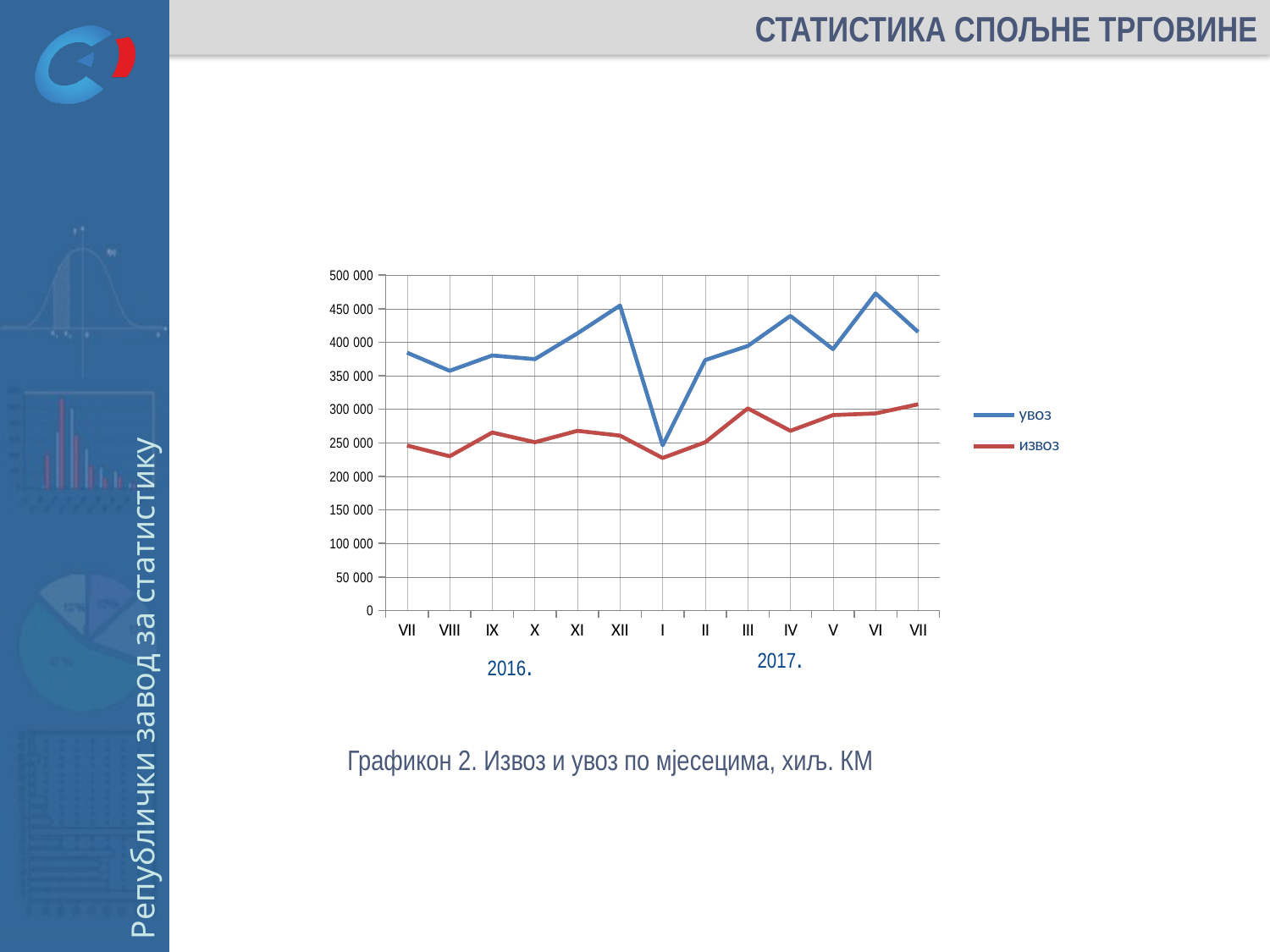
In which month is the увоз (blue) line at its highest? VI 2017 What kind of chart is shown on the slide? line chart In which month is the извоз (red) line at its lowest? I 2017 In which month is the увоз (blue) line at its lowest? I 2017 Which is larger in XII 2016, увоз or извоз? увоз Is the value of извоз in VIII 2016 greater or less than 250 000? less How many series does the legend list? 2 Is the value of увоз in VI 2017 greater or less than 450 000? greater How many months are plotted along the x axis? 13 Which colour is used for the извоз series? red Is the value of увоз in I 2017 greater or less than 300 000? less Does the увоз line rise or fall from VIII 2016 to XII 2016? rise